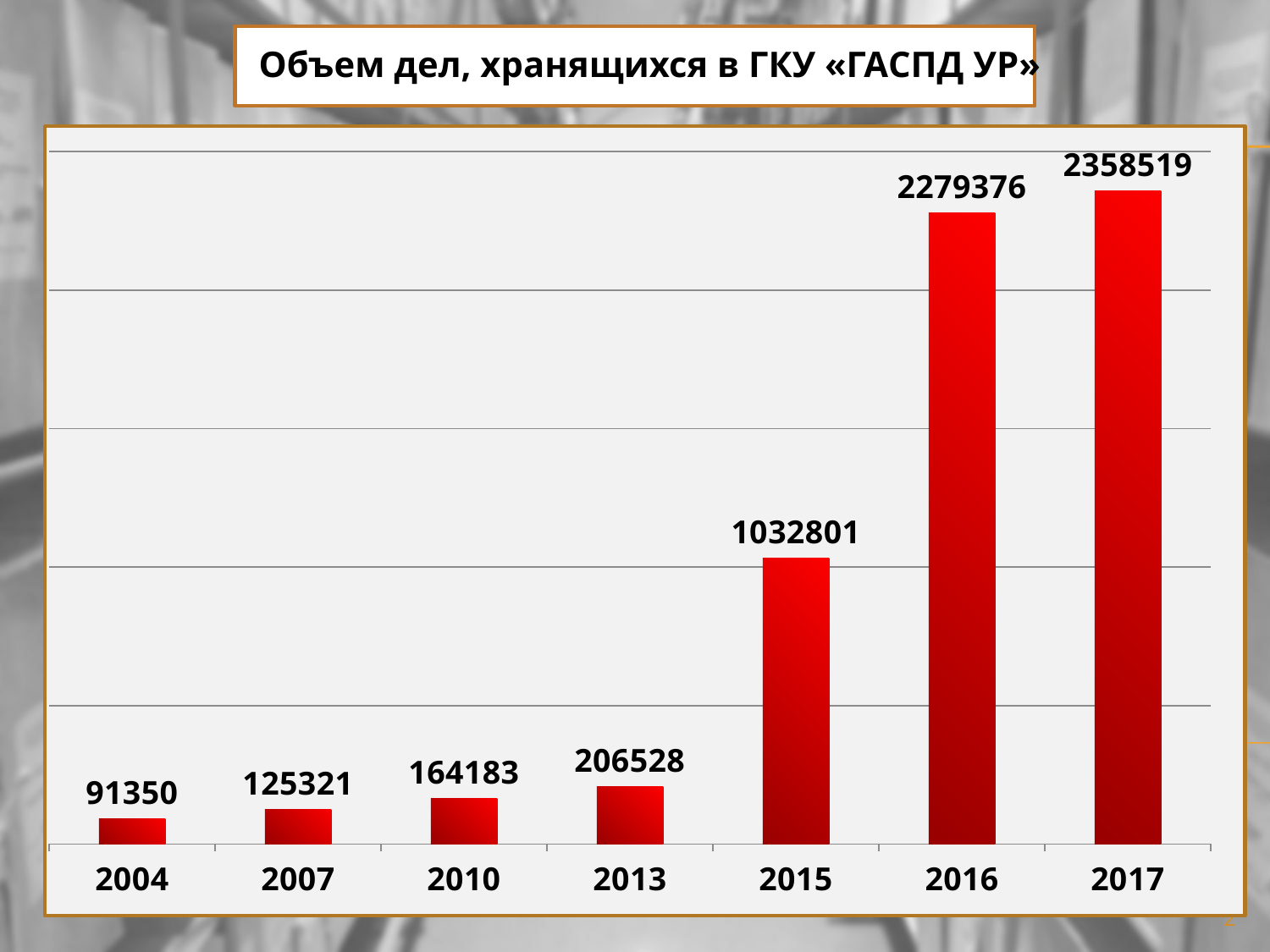
What is the value for 2015? 1032801 What is the value for 2004? 91350 Do the values rise or fall from 2004 to 2017? Rise Which is larger, the value for 2013 or the value for 2010? 2013 What is the value for 2017? 2358519 Which year has the lowest value? 2004 What is the difference between the values for 2015 and 2013? 826273 Which year has the highest value? 2017 How many years are shown on the x axis? 7 What is the value for 2010? 164183 What is the difference between the values for 2017 and 2016? 79143 What kind of chart is shown on the slide? Bar chart